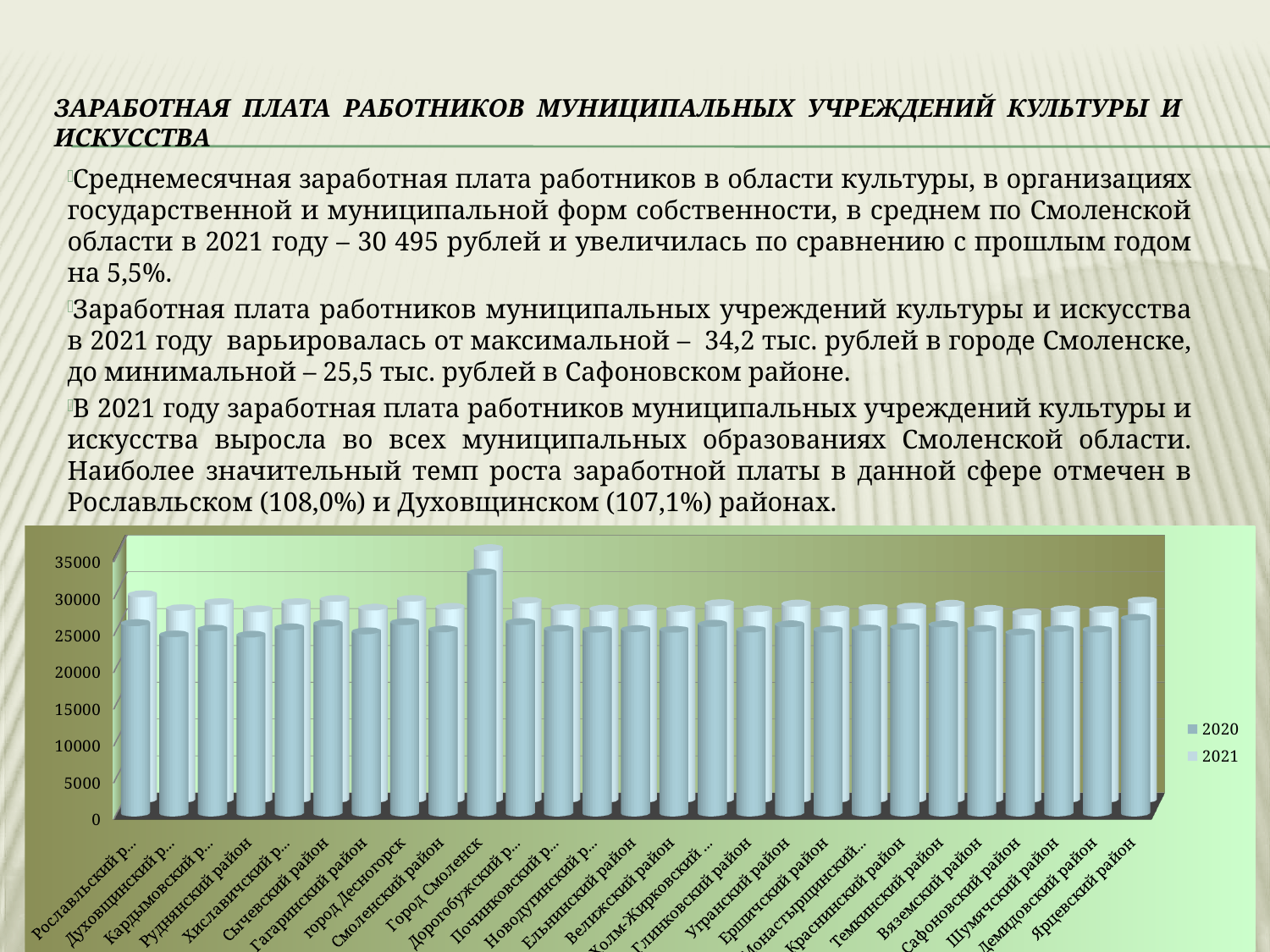
Is the 2020 value for Духовщинский район greater or less than 30000? less Which is larger for 2021: the value for Город Смоленск or the value for Сафоновский район? Город Смоленск Is the 2021 value for Сафоновский район greater or less than 30000? less Is the 2021 value for Рославльский район greater or less than 25000? greater How many series does the chart legend list? 2 What are the two series named in the chart legend? 2020 and 2021 For Рославльский район, which series has the larger value, 2020 or 2021? 2021 What kind of chart is shown on the slide? bar chart Which category has the highest value for the 2021 series? Город Смоленск What is the highest tick value shown on the vertical axis of the chart? 35000